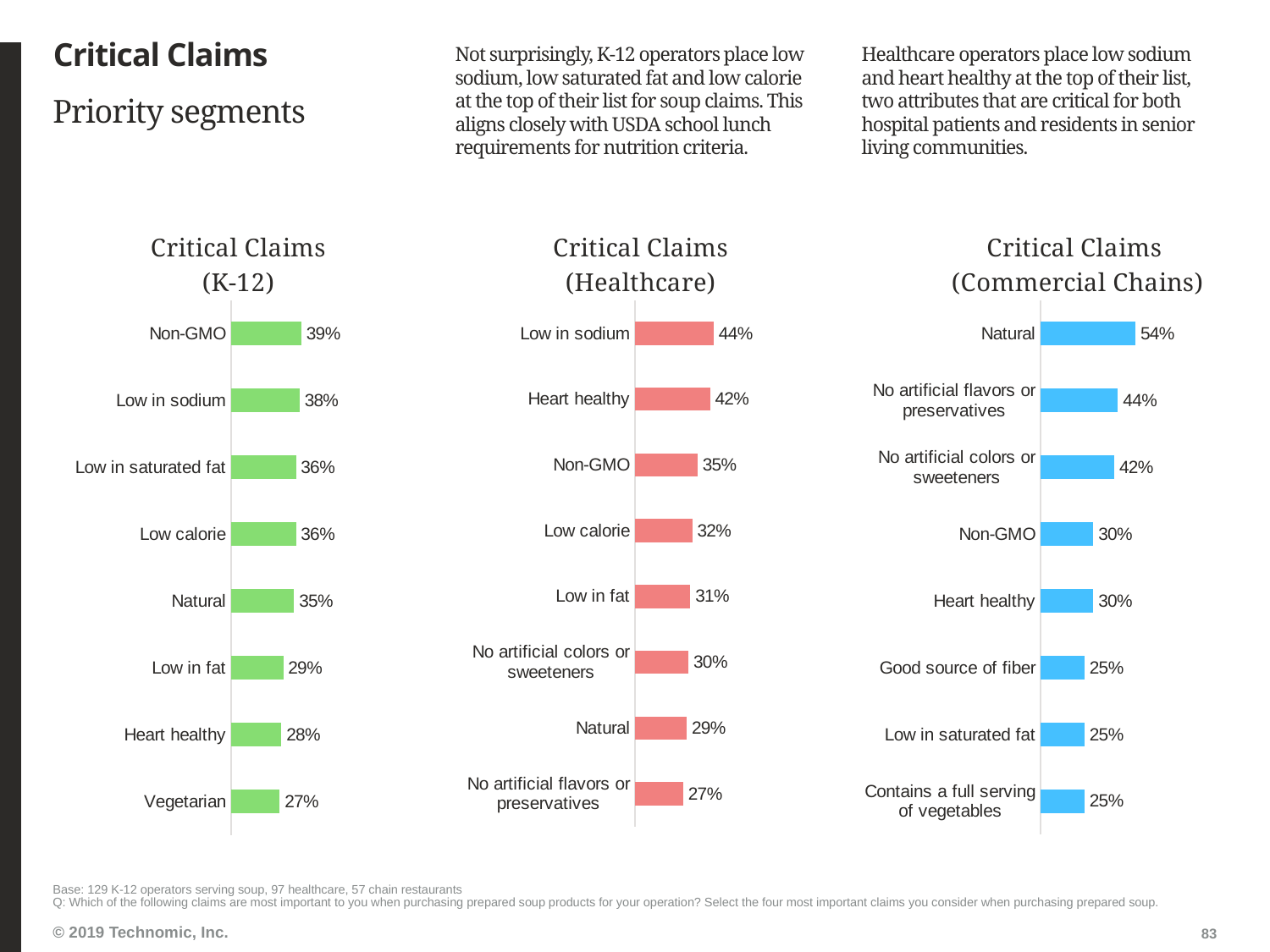
In the Critical Claims (Healthcare) chart, what percentage is shown for Heart healthy? 42% How many claims are listed in the Critical Claims (Commercial Chains) chart? 8 In the Critical Claims (K-12) chart, which claim has the lowest percentage? Vegetarian In the Critical Claims (Commercial Chains) chart, what percentage is shown for Natural? 54% In the Critical Claims (Healthcare) chart, which claim has the highest percentage? Low in sodium In the Critical Claims (K-12) chart, which is larger: Low in sodium or Heart healthy? Low in sodium In the Critical Claims (Healthcare) chart, what is the difference between Low in sodium and No artificial flavors or preservatives? 17% In the Critical Claims (Healthcare) chart, what percentage is shown for Low calorie? 32% In the Critical Claims (K-12) chart, what percentage is shown for Non-GMO? 39% What type of chart is the Critical Claims (K-12) chart? Bar chart In the Critical Claims (Commercial Chains) chart, what is the difference between Natural and Non-GMO? 24% What colour are the bars in the Critical Claims (Healthcare) chart? Red